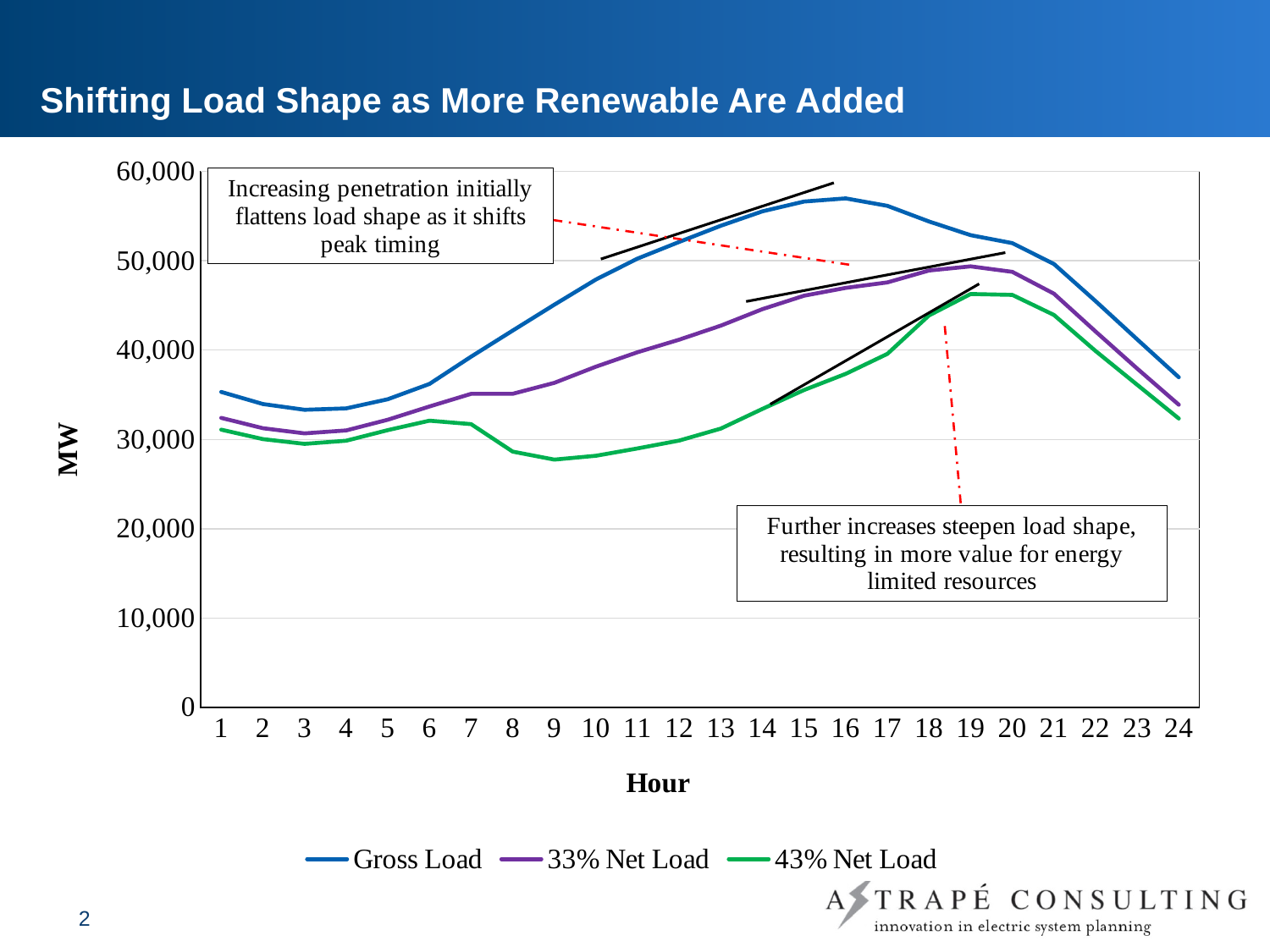
Does the Gross Load series rise or fall between hour 9 and hour 16? rise At hour 12, which series has the larger value, Gross Load or 43% Net Load? Gross Load How many hours are plotted along the x axis? 24 At which hour does the 43% Net Load series reach its lowest value? 9 At hour 9, which series has the larger value, 33% Net Load or 43% Net Load? 33% Net Load Is the Gross Load value at hour 16 greater or less than 50,000? greater Is the Gross Load value at hour 24 greater or less than 40,000? less Is the 43% Net Load value at hour 9 greater or less than 30,000? less How many series does the legend list? 3 At which hour does the Gross Load series reach its highest value? 16 What is the label on the y axis of the chart? MW What kind of chart is shown on the slide? Line chart